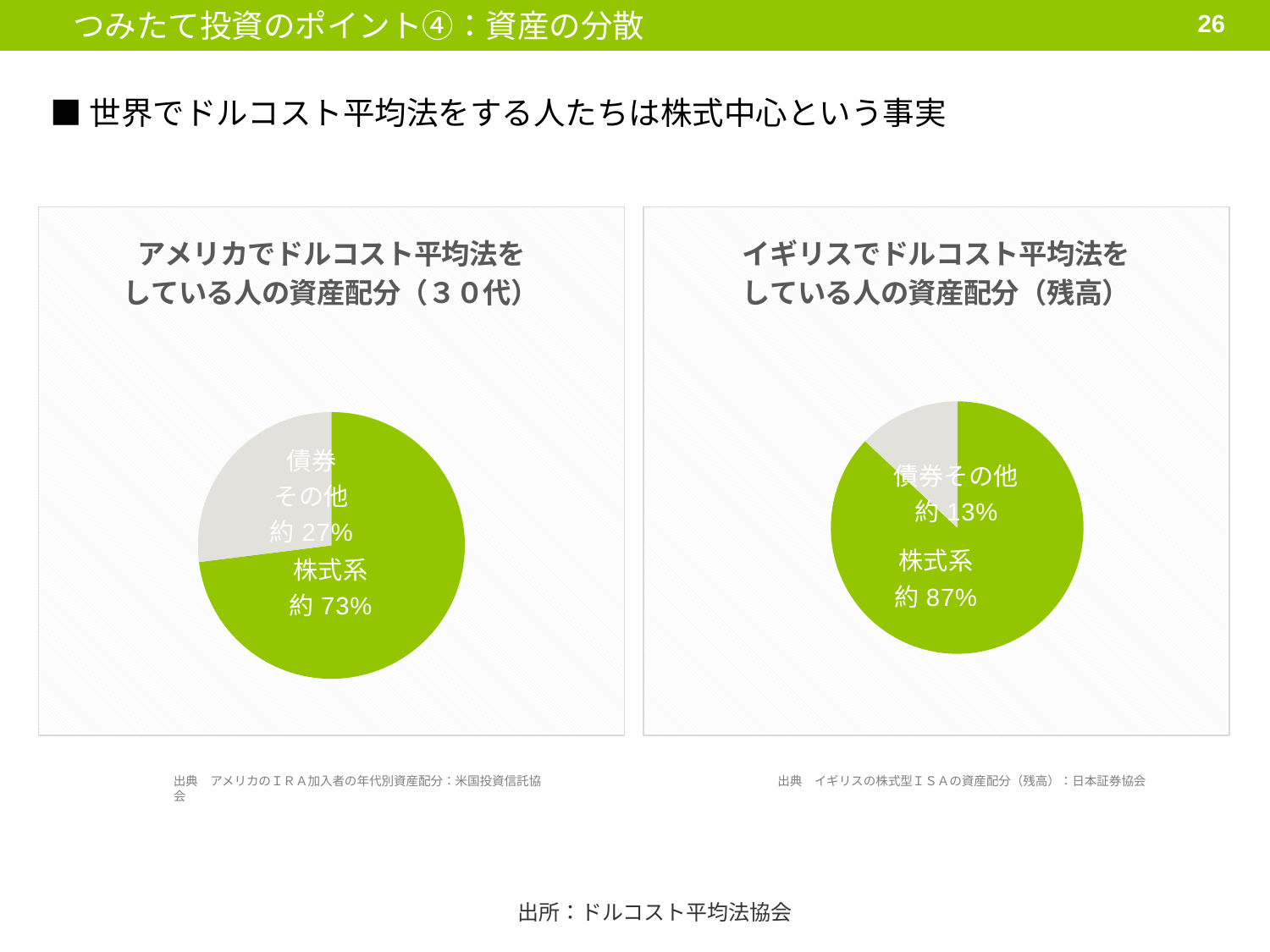
In the right pie chart (イギリス), which category has the smallest share? 債券その他 In the right pie chart (イギリスでドルコスト平均法をしている人の資産配分（残高）), what is the value shown for 債券その他? 約 13% In the right pie chart (イギリス), how many percentage points larger is 株式系 than 債券その他? 74 percentage points In the left pie chart (アメリカでドルコスト平均法をしている人の資産配分（３０代）), what is the value shown for 株式系? 約 73% In the right pie chart (イギリスでドルコスト平均法をしている人の資産配分（残高）), what is the value shown for 株式系? 約 87% How many slices does the left pie chart (アメリカ) have? 2 What type of chart is used on the right side of the slide (イギリス)? pie chart Comparing the 株式系 shares, which chart shows the larger value: the left (アメリカ) chart or the right (イギリス) chart? the right (イギリス) chart In the right pie chart (イギリス), what colour is the 株式系 slice? green In the left pie chart (アメリカ), how many percentage points larger is 株式系 than 債券その他? 46 percentage points In the left pie chart (アメリカ), which category has the largest share? 株式系 In the left pie chart (アメリカでドルコスト平均法をしている人の資産配分（３０代）), what is the value shown for 債券その他? 約 27%